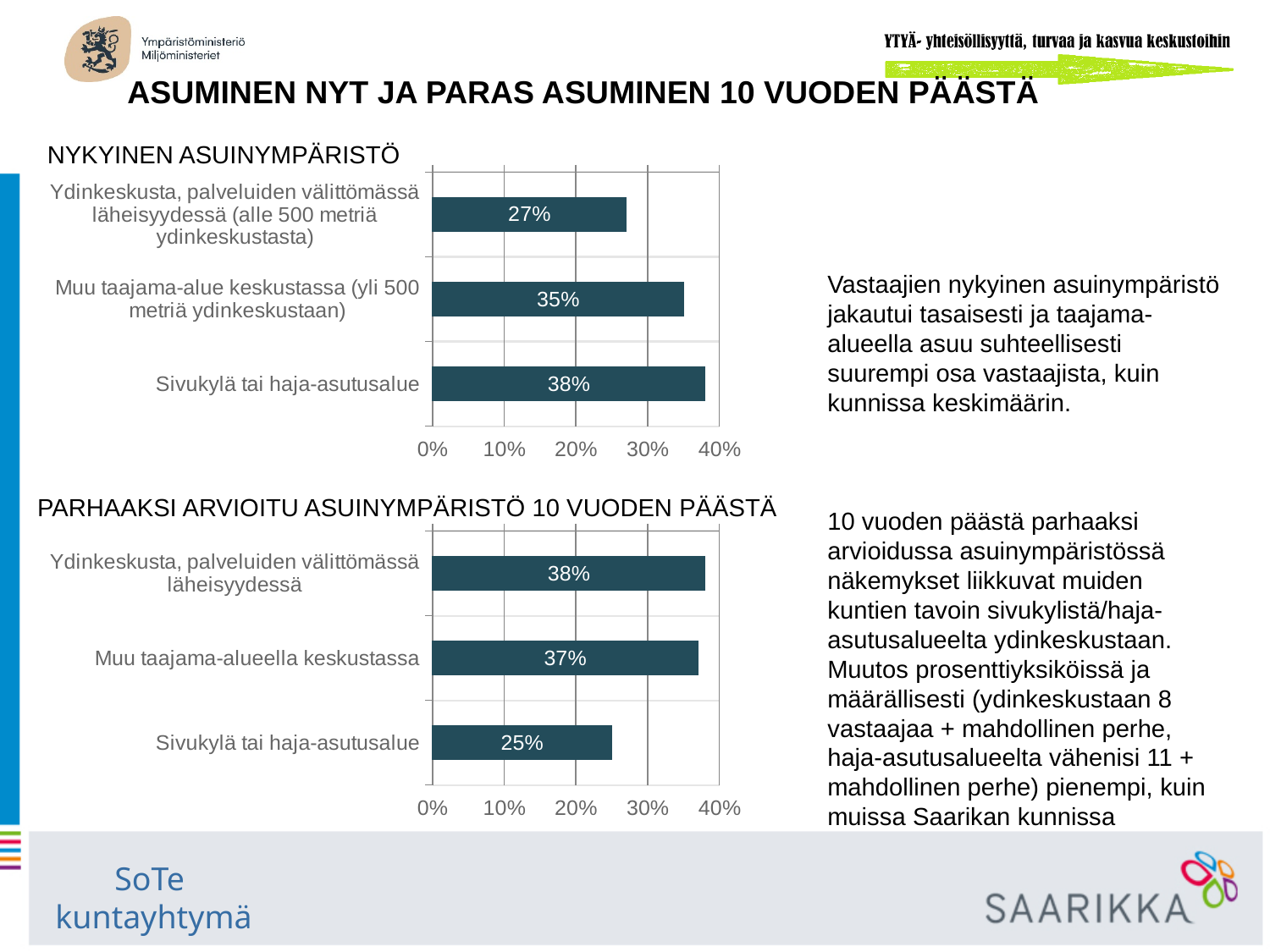
In the 'NYKYINEN ASUINYMPÄRISTÖ' chart, what is the value for 'Sivukylä tai haja-asutusalue'? 38% In the 'NYKYINEN ASUINYMPÄRISTÖ' chart, is the value for 'Sivukylä tai haja-asutusalue' greater or less than 30%? greater In the 'PARHAAKSI ARVIOITU ASUINYMPÄRISTÖ 10 VUODEN PÄÄSTÄ' chart, what is the difference between 'Muu taajama-alueella keskustassa' and 'Sivukylä tai haja-asutusalue'? 12% In the 'PARHAAKSI ARVIOITU ASUINYMPÄRISTÖ 10 VUODEN PÄÄSTÄ' chart, what is the value for 'Sivukylä tai haja-asutusalue'? 25% In the 'PARHAAKSI ARVIOITU ASUINYMPÄRISTÖ 10 VUODEN PÄÄSTÄ' chart, which is larger: 'Muu taajama-alueella keskustassa' or 'Sivukylä tai haja-asutusalue'? Muu taajama-alueella keskustassa In the 'NYKYINEN ASUINYMPÄRISTÖ' chart, which category has the lowest value? Ydinkeskusta, palveluiden välittömässä läheisyydessä (alle 500 metriä ydinkeskustasta) In the 'NYKYINEN ASUINYMPÄRISTÖ' chart, what is the difference between 'Sivukylä tai haja-asutusalue' and 'Ydinkeskusta, palveluiden välittömässä läheisyydessä'? 11% In the 'NYKYINEN ASUINYMPÄRISTÖ' chart, what is the value for 'Muu taajama-alue keskustassa (yli 500 metriä ydinkeskustaan)'? 35% What kind of chart is the 'PARHAAKSI ARVIOITU ASUINYMPÄRISTÖ 10 VUODEN PÄÄSTÄ' chart? Bar chart How many categories does the 'NYKYINEN ASUINYMPÄRISTÖ' chart show? 3 In the 'PARHAAKSI ARVIOITU ASUINYMPÄRISTÖ 10 VUODEN PÄÄSTÄ' chart, what is the value for 'Ydinkeskusta, palveluiden välittömässä läheisyydessä'? 38% In the 'PARHAAKSI ARVIOITU ASUINYMPÄRISTÖ 10 VUODEN PÄÄSTÄ' chart, which category has the highest value? Ydinkeskusta, palveluiden välittömässä läheisyydessä